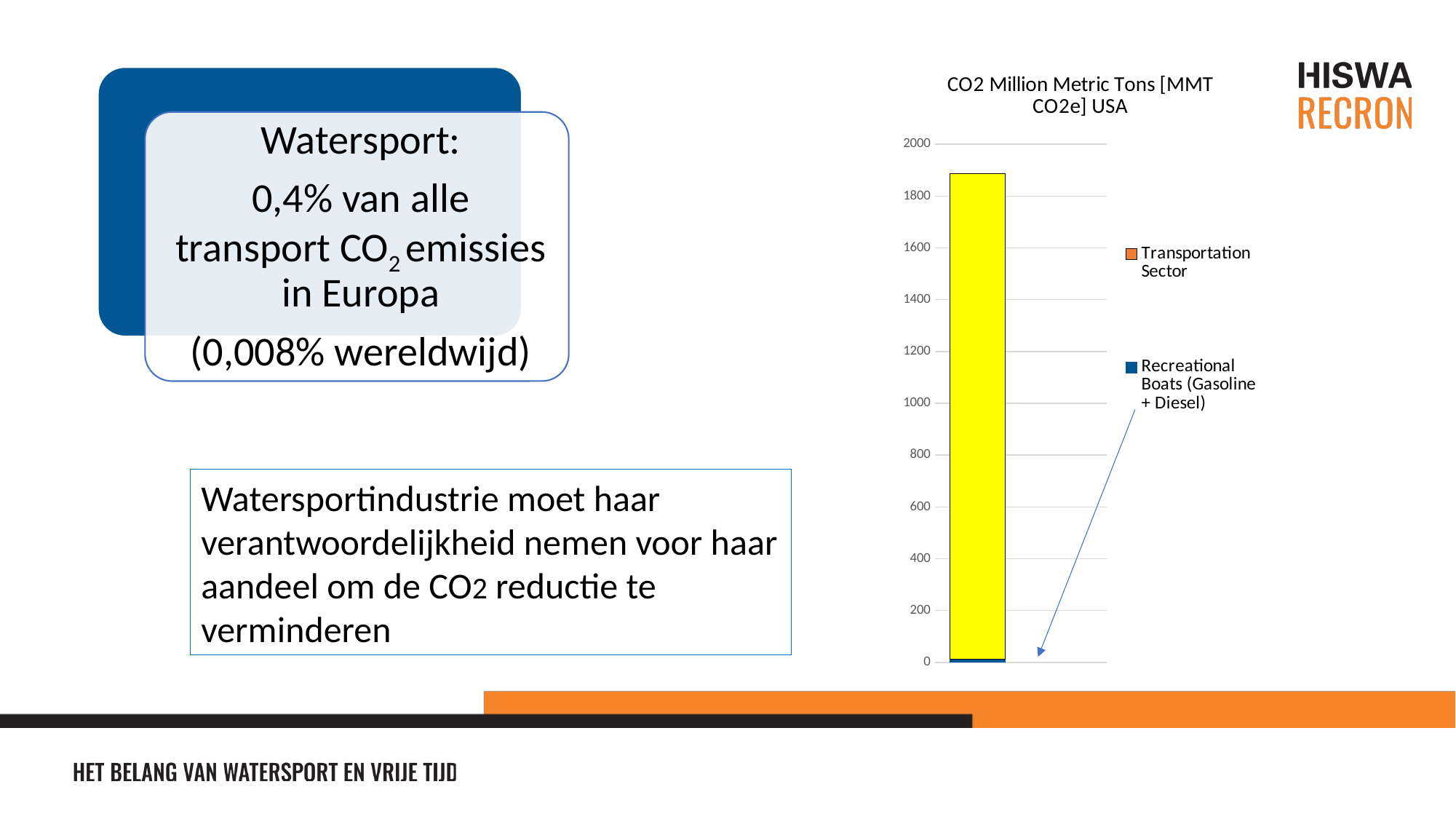
How many bars are plotted in the chart? 1 Which series is larger, Transportation Sector or Recreational Boats (Gasoline + Diesel)? Transportation Sector Is the value for Transportation Sector greater or less than 2000? less What is the highest value shown on the chart's vertical axis? 2000 Which series has the smallest value in the chart? Recreational Boats (Gasoline + Diesel) Is the value for Transportation Sector greater or less than 1800? greater What is the title of the chart? CO2 Million Metric Tons [MMT CO2e] USA Is the total height of the stacked bar greater or less than 1600? greater What kind of chart is shown on the slide? Stacked bar chart How many series does the chart legend list? 2 Which two series are listed in the chart legend? Transportation Sector; Recreational Boats (Gasoline + Diesel)